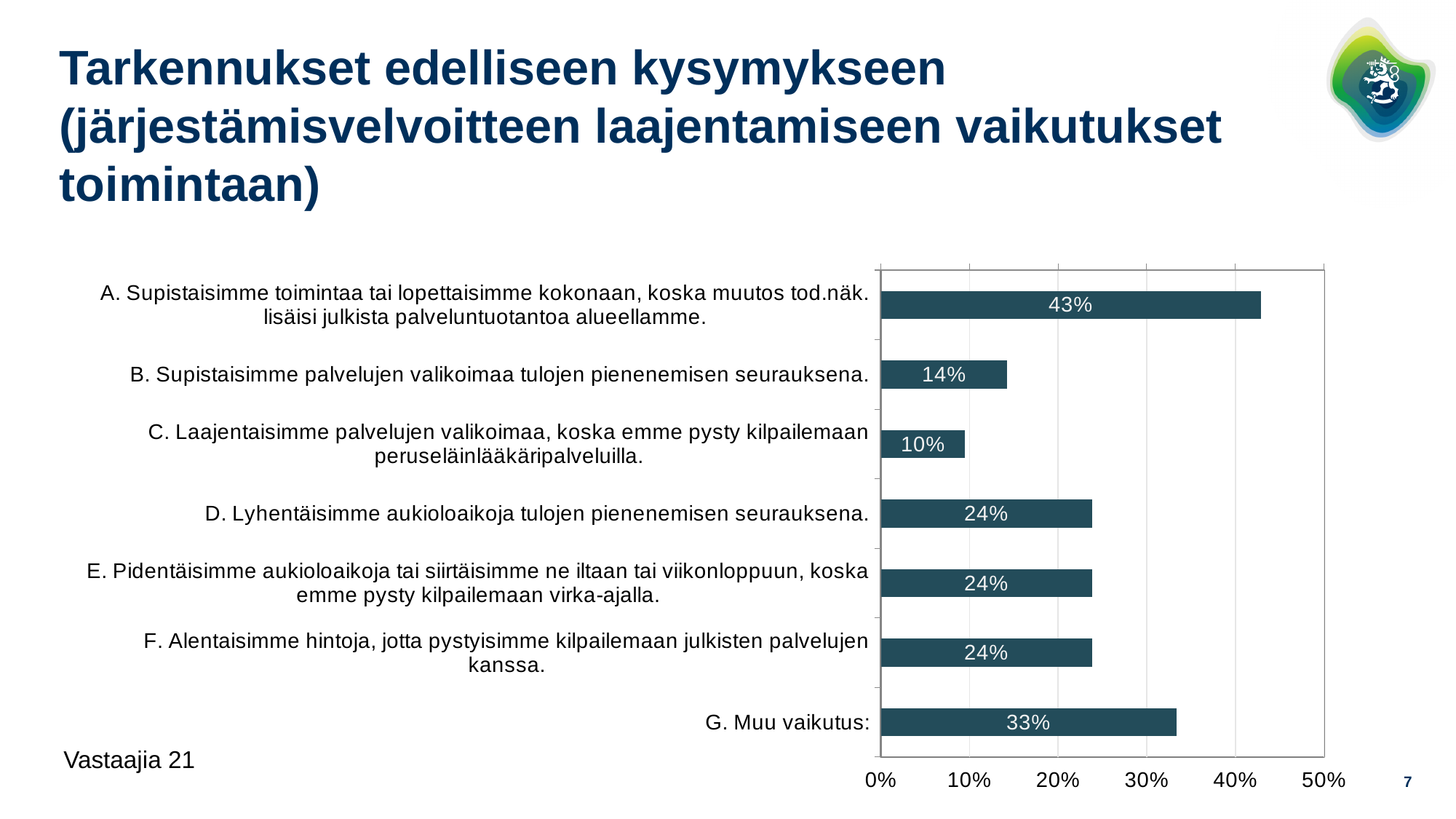
Which option has the highest value? A. Supistaisimme toimintaa tai lopettaisimme kokonaan Which option has the lowest value? C. Laajentaisimme palvelujen valikoimaa What is the value for option A (Supistaisimme toimintaa tai lopettaisimme kokonaan)? 43% What is the difference between the values for option D and option B? 10% What kind of chart is shown on the slide? Bar chart Is the value for option A greater or less than 40%? greater What is the value for option G (Muu vaikutus)? 33% What is the value for option B (Supistaisimme palvelujen valikoimaa tulojen pienenemisen seurauksena)? 14% What is the difference between the values for option A and option G? 10% Which is larger, the value for option G or the value for option F? G. Muu vaikutus What is the value for option C (Laajentaisimme palvelujen valikoimaa)? 10% How many options (categories) are shown in the chart? 7